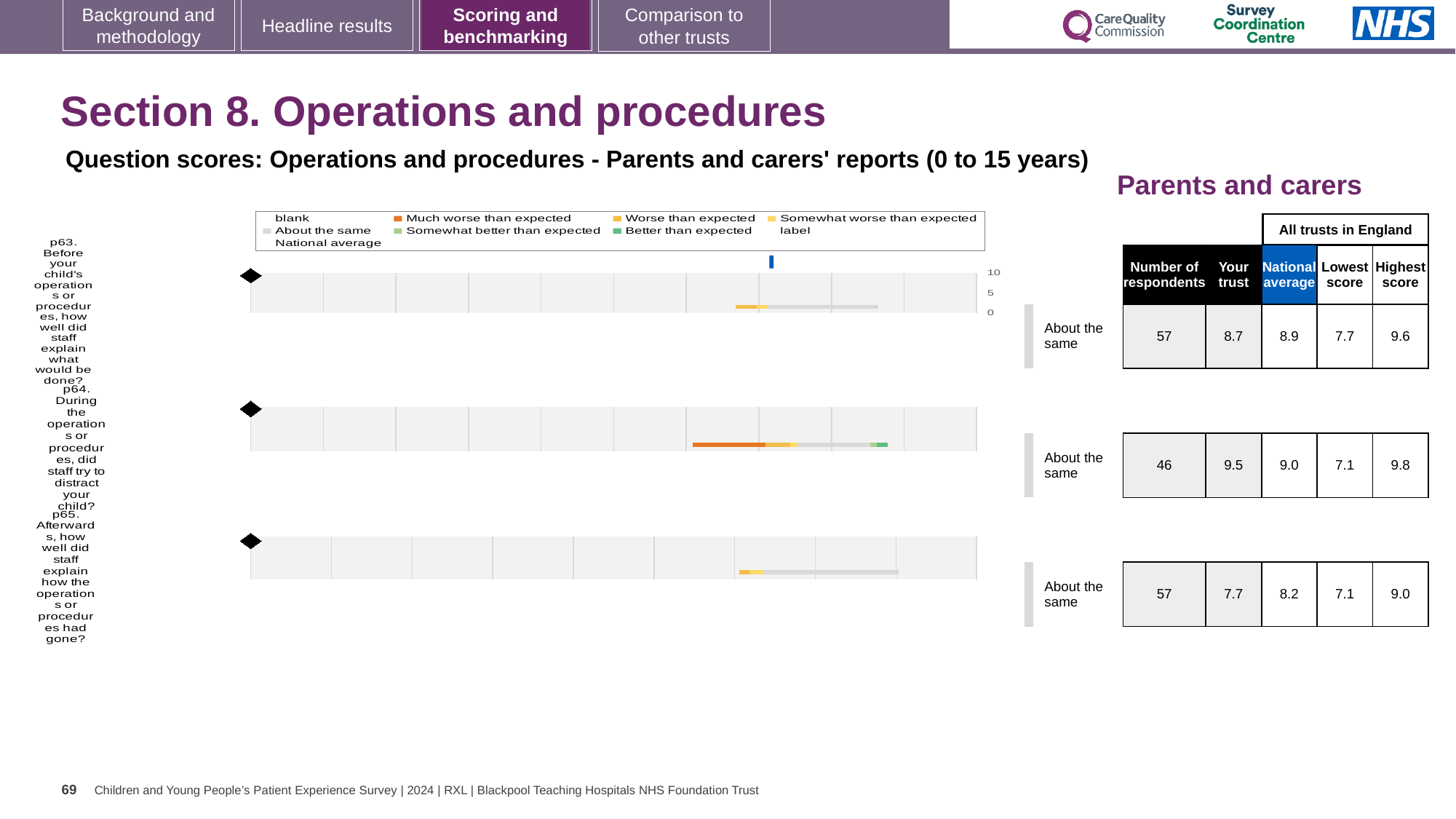
What kind of chart is used to show the question scores on this slide? bar chart Which question has the highest 'Your trust' score? p64 What is the 'Your trust' score for p64 (During the operations or procedures, did staff try to distract your child?)? 9.5 What is the Lowest score across all trusts in England for p63? 7.7 How many respondents answered p64? 46 Which question has the lowest 'Your trust' score? p65 For p63, what is the difference between the National average (8.9) and the 'Your trust' score (8.7)? 0.2 What is the Highest score across all trusts in England for p65 (Afterwards, how well did staff explain how the operations or procedures had gone?)? 9.0 How many questions (chart rows) are shown on the slide? 3 For p64, which is larger: the 'Your trust' score or the National average? Your trust What is the National average score for p63 (Before your child's operations or procedures, how well did staff explain what would be done?)? 8.9 What benchmark category is shown for p65? About the same